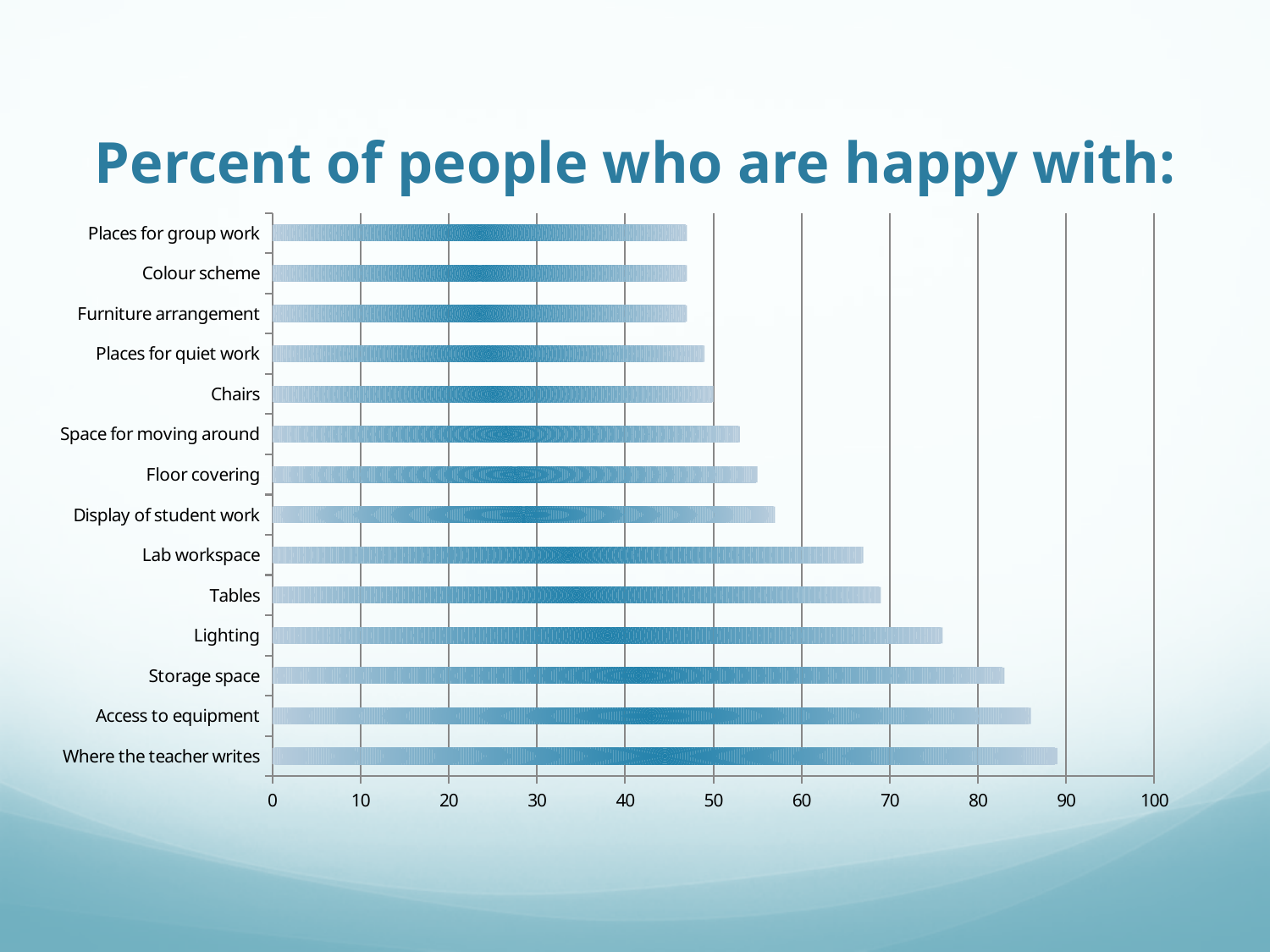
Which is larger, the value for Tables or the value for Floor covering? Tables What is the title of the chart? Percent of people who are happy with: What kind of chart is shown on the slide? bar chart How many categories are plotted in the chart? 14 Is the value for Places for group work greater or less than 50? less Is the value for Lighting greater or less than 70? greater Which category has the highest value? Where the teacher writes Is the value for Display of student work greater or less than 60? less Which is larger, the value for Access to equipment or the value for Lighting? Access to equipment